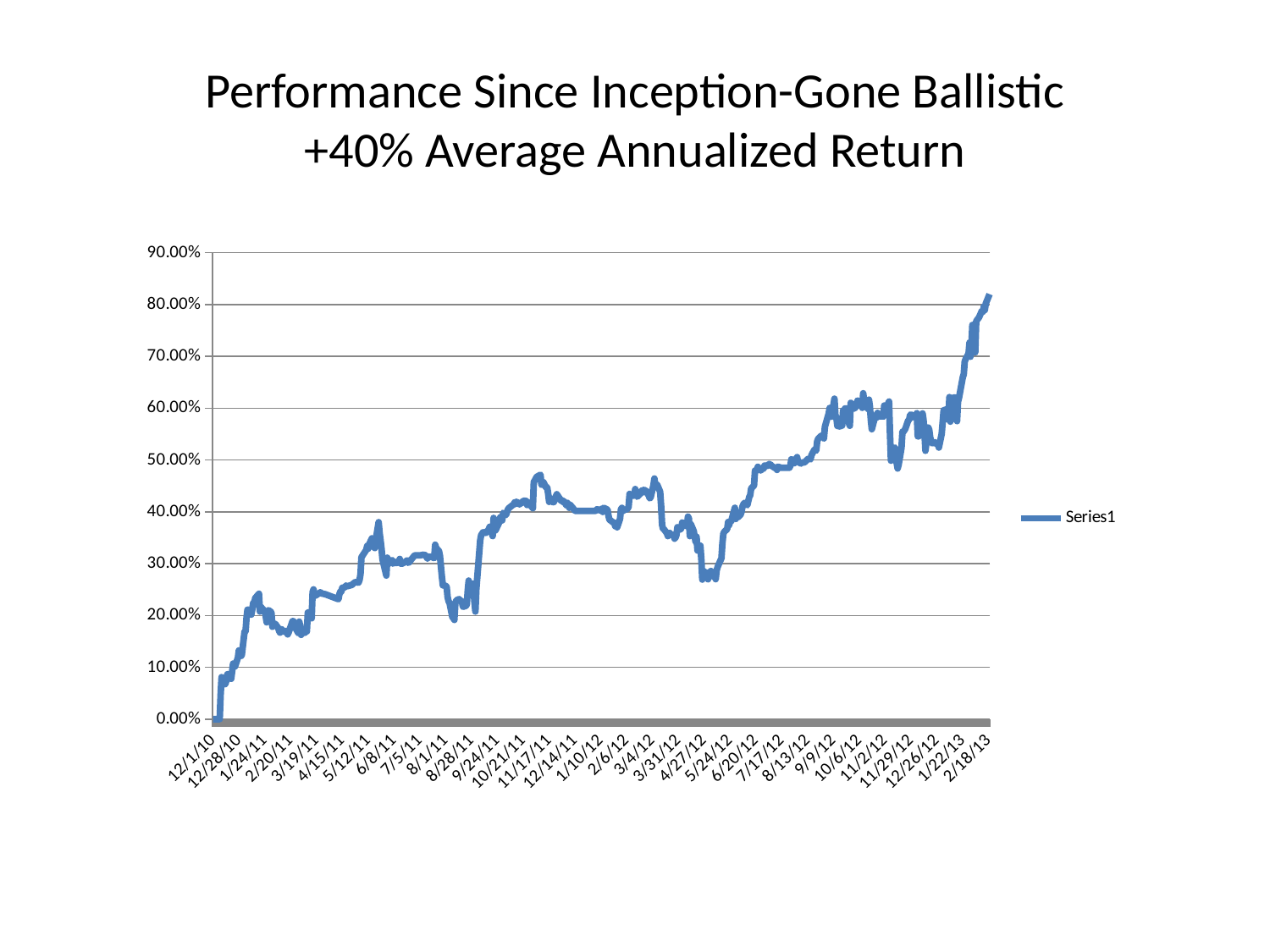
What kind of chart is shown on the slide? line chart Is the value at 10/6/12 greater or less than 50.00%? greater Which date has the larger value, 4/27/12 or 10/6/12? 10/6/12 Is the value at 8/28/11 greater or less than 30.00%? less Around which date on the x axis does the line reach its highest value? 2/18/13 Is the value at 2/18/13 greater or less than 70.00%? greater What is the title of the chart on the slide? Performance Since Inception-Gone Ballistic +40% Average Annualized Return Overall, does the line rise or fall from 12/1/10 to 2/18/13? rise What is the name of the series shown in the legend? Series1 How many series does the legend list? 1